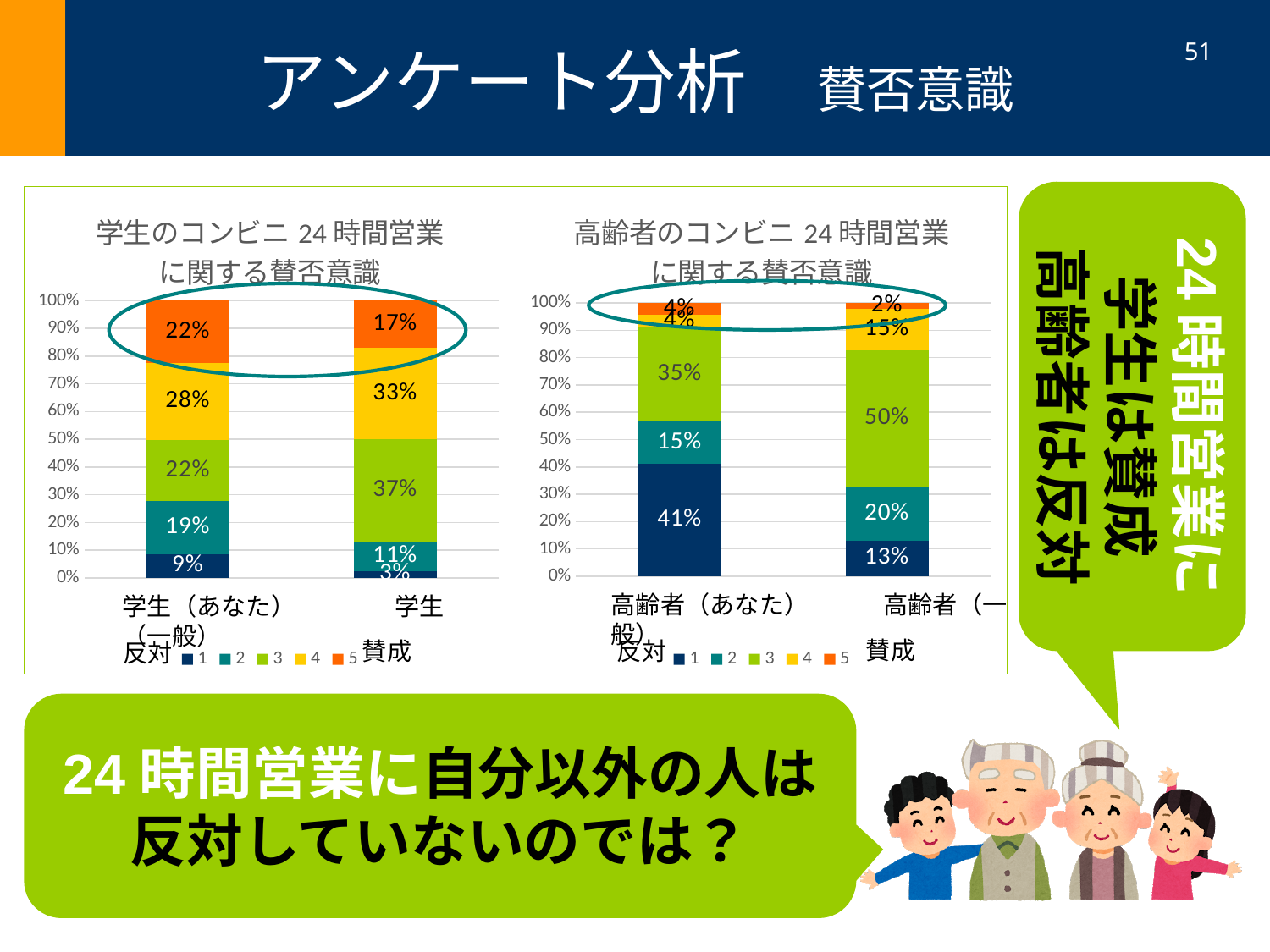
What kind of chart is the left chart? Stacked bar chart What is the title of the right chart? 高齢者のコンビニ24時間営業に関する賛否意識 In the left chart (学生のコンビニ24時間営業に関する賛否意識), what is the value of series 3 for 学生（一般）? 37% In the right chart (高齢者のコンビニ24時間営業に関する賛否意識), what is the value of series 1 for 高齢者（あなた）? 41% In the left chart, which series has the largest share in the 学生（一般） bar? 3 How many categories are shown on the x axis of the right chart? 2 In the right chart, which is larger: series 1 for 高齢者（あなた） or series 1 for 高齢者（一般）? 高齢者（あなた） How many series does the legend of the left chart list? 5 In the right chart, which series has the smallest share in the 高齢者（一般） bar? 5 In the left chart, what is the difference between the series 5 values for 学生（あなた） and 学生（一般）? 5% In the left chart (学生のコンビニ24時間営業に関する賛否意識), what is the value of series 5 for 学生（あなた）? 22% In the right chart (高齢者のコンビニ24時間営業に関する賛否意識), what is the value of series 3 for 高齢者（一般）? 50%